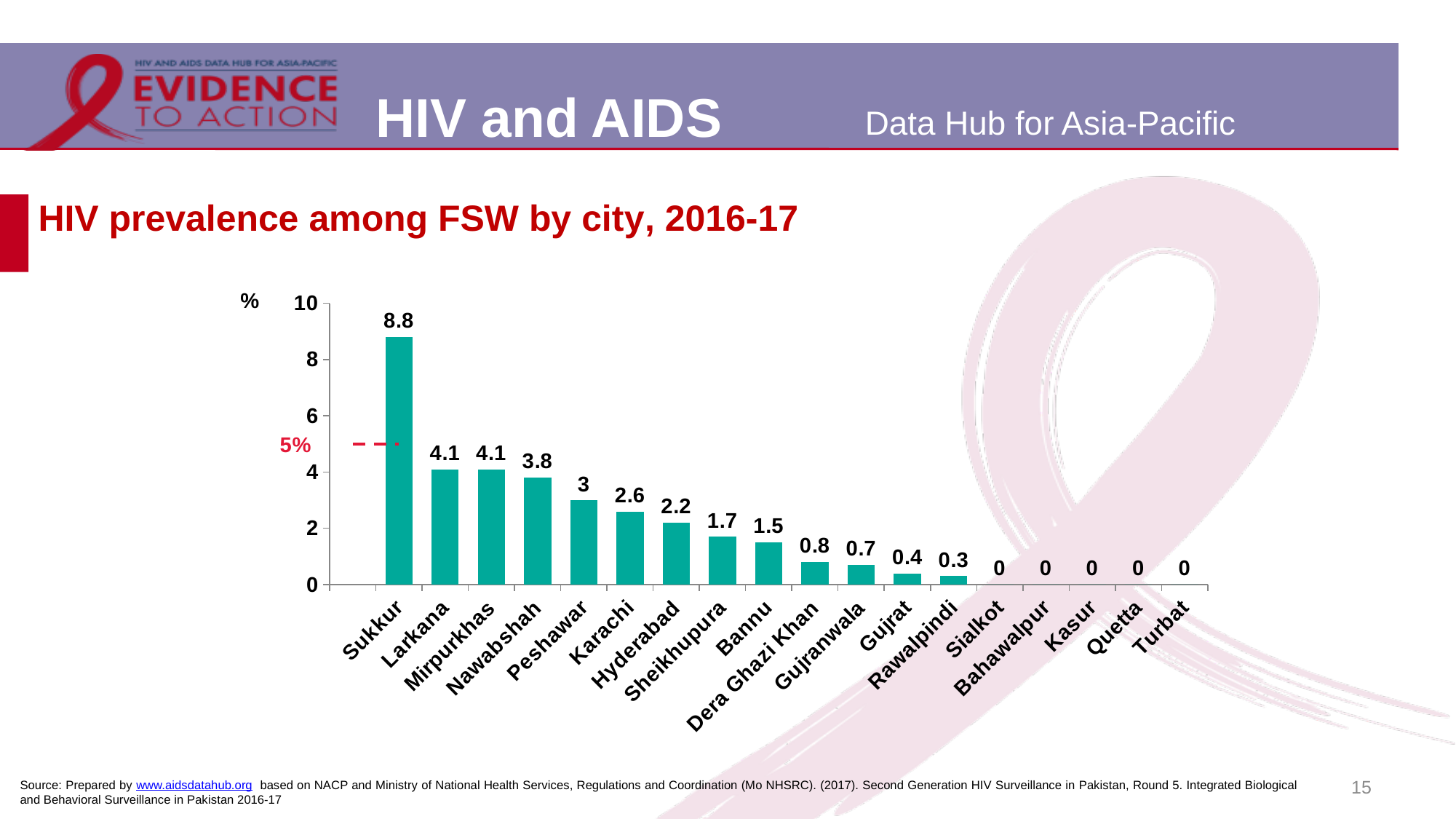
What is the difference in HIV prevalence between Sukkur and Nawabshah? 5 What kind of chart is used to show HIV prevalence among FSW by city? Bar chart What is the difference in HIV prevalence between Peshawar and Hyderabad? 0.8 What value does the red dashed reference line on the chart mark? 5% What is the HIV prevalence among FSW in Karachi? 2.6 Which city has the highest HIV prevalence among FSW? Sukkur How many cities show an HIV prevalence of 0? 5 Is the HIV prevalence for Sukkur greater or less than 8? greater Which city has a higher HIV prevalence among FSW, Bannu or Sheikhupura? Sheikhupura What is the HIV prevalence among FSW in Rawalpindi? 0.3 How many cities are shown on the chart? 18 What is the HIV prevalence among FSW in Sukkur? 8.8